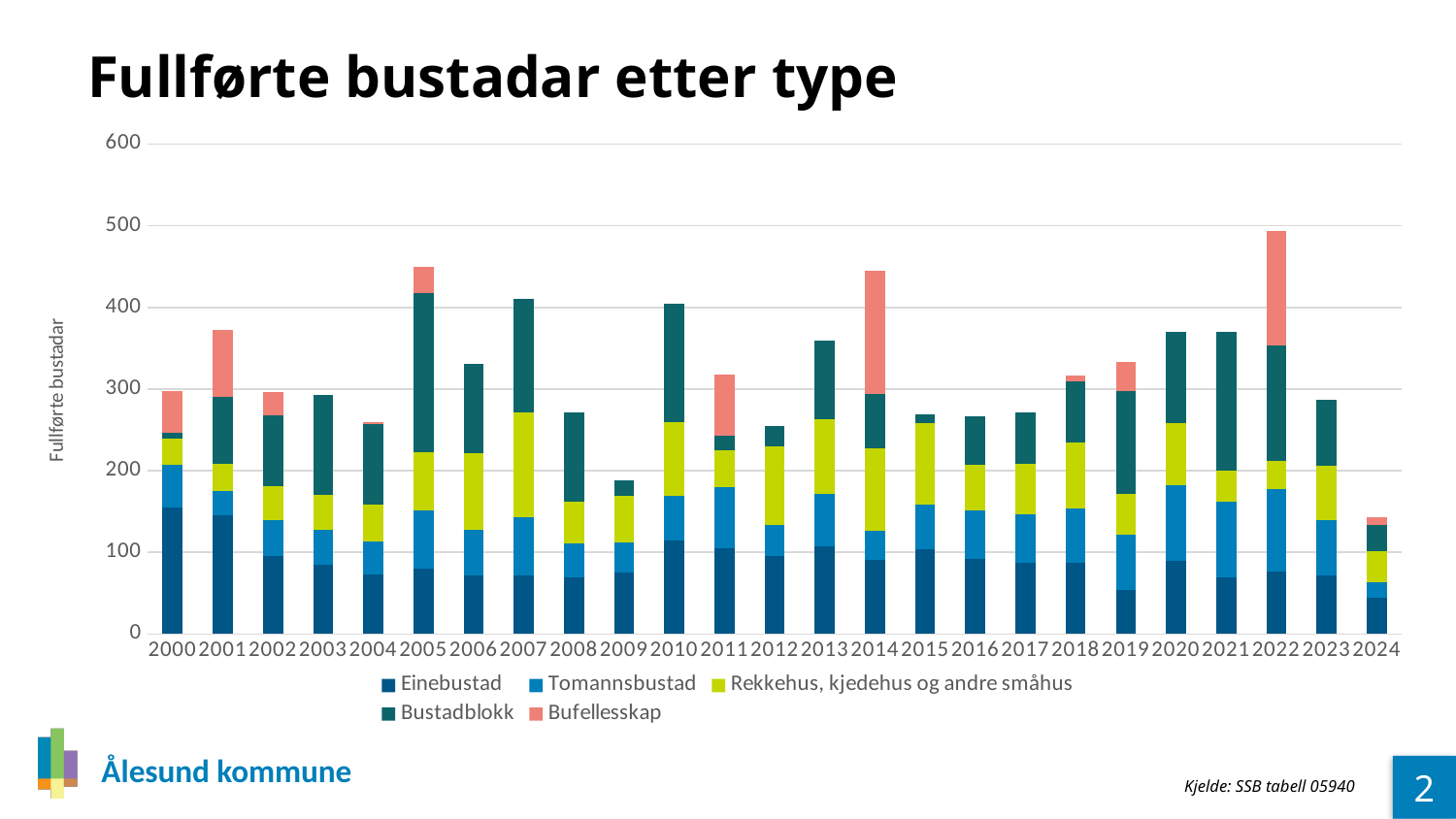
Is the total for 2014 greater or less than 400? greater Which year has a larger total, 2022 or 2023? 2022 What kind of chart is shown on the slide? Stacked bar chart Which series is shown in the salmon/red colour at the top of the bars? Bufellesskap Is the total for 2022 greater or less than 400? greater What is the title of the chart? Fullførte bustadar etter type Is the total for 2024 greater or less than 200? less Which year has the highest total of completed dwellings? 2022 How many years are shown along the x axis? 25 Which year has the lowest total of completed dwellings? 2024 Which year has a larger total, 2004 or 2005? 2005 How many series does the legend list? 5